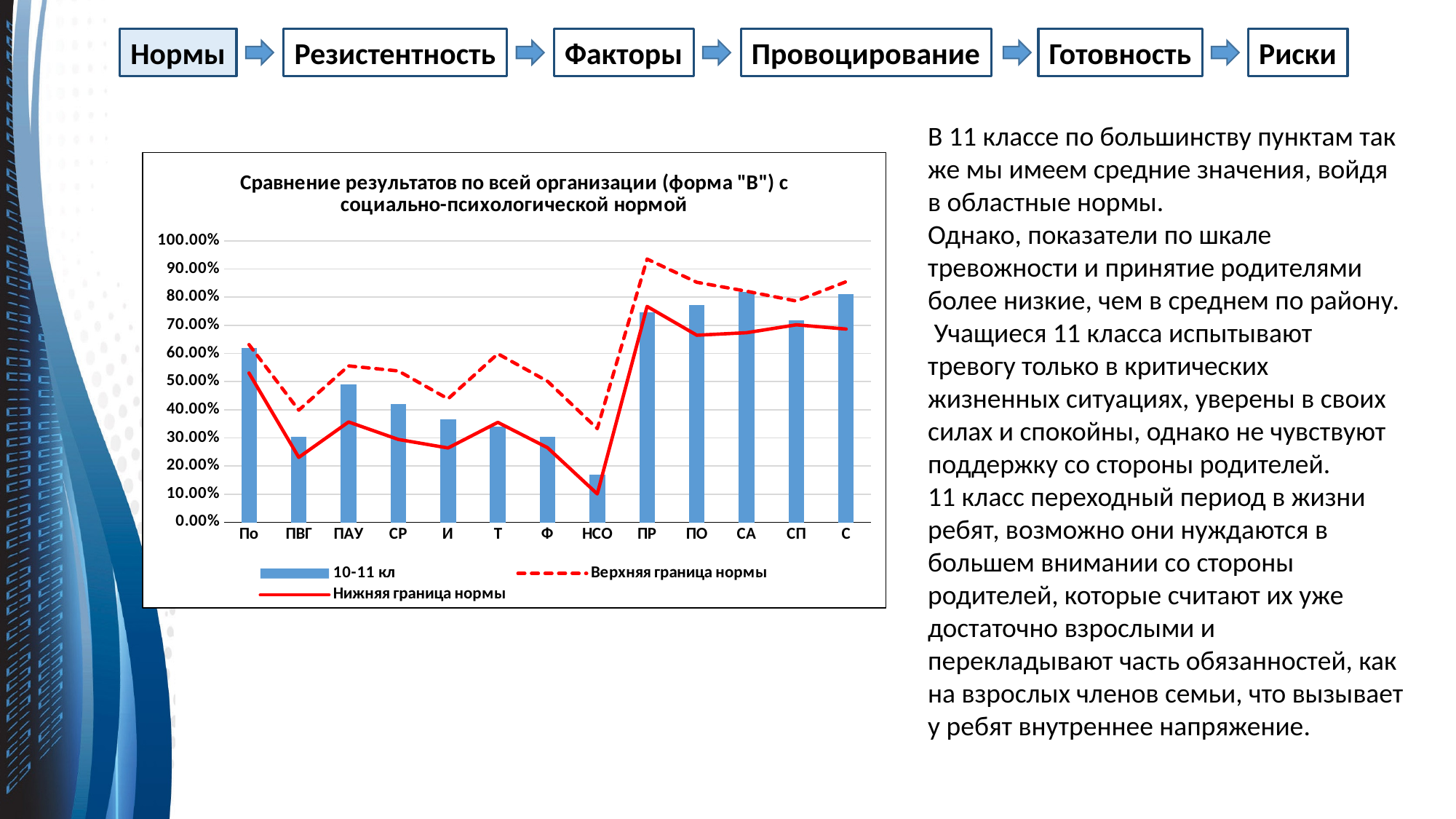
How many categories are shown on the x axis of the chart? 13 What kind of chart is shown on the slide? combination bar and line chart Is the 10-11 кл bar for НСО greater or less than 20.00%? less Which has the larger 10-11 кл bar, ПО or Ф? ПО Which legend entry is drawn as a dashed red line? Верхняя граница нормы Is the 10-11 кл bar for ПР greater or less than 70.00%? greater What is the title of the chart? Сравнение результатов по всей организации (форма "В") с социально-психологической нормой How many series does the chart legend list? 3 Which category has the lowest bar for 10-11 кл? НСО Is the 10-11 кл bar for И greater or less than 40.00%? less Which has the larger 10-11 кл bar, По or ПВГ? По